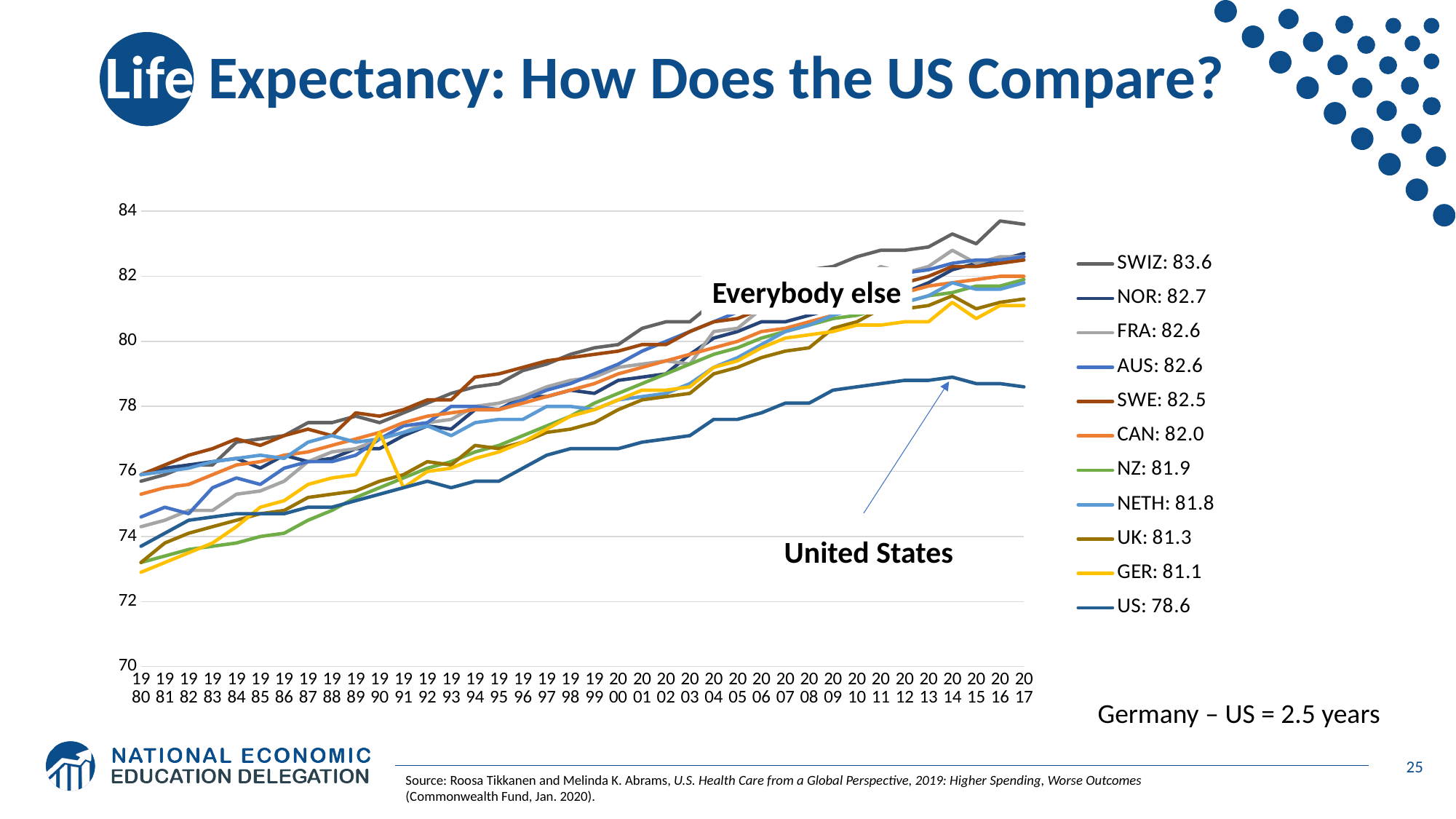
How many series does the legend list? 11 Which country has the highest value in the legend? SWIZ Is the value for the US in 2017 greater or less than 80? less Do the life expectancy lines generally rise or fall from 1980 to 2017? rise Which has the larger legend value, CAN or NZ? CAN What is the difference between the legend values for SWIZ and the US? 5.0 What value is shown in the legend for SWIZ? 83.6 What kind of chart is shown on the slide? line chart What value is shown in the legend for the US? 78.6 What value is shown in the legend for GER? 81.1 Which country has the lowest value in the legend? US According to the text on the slide, how many years is the gap between Germany and the US? 2.5 years